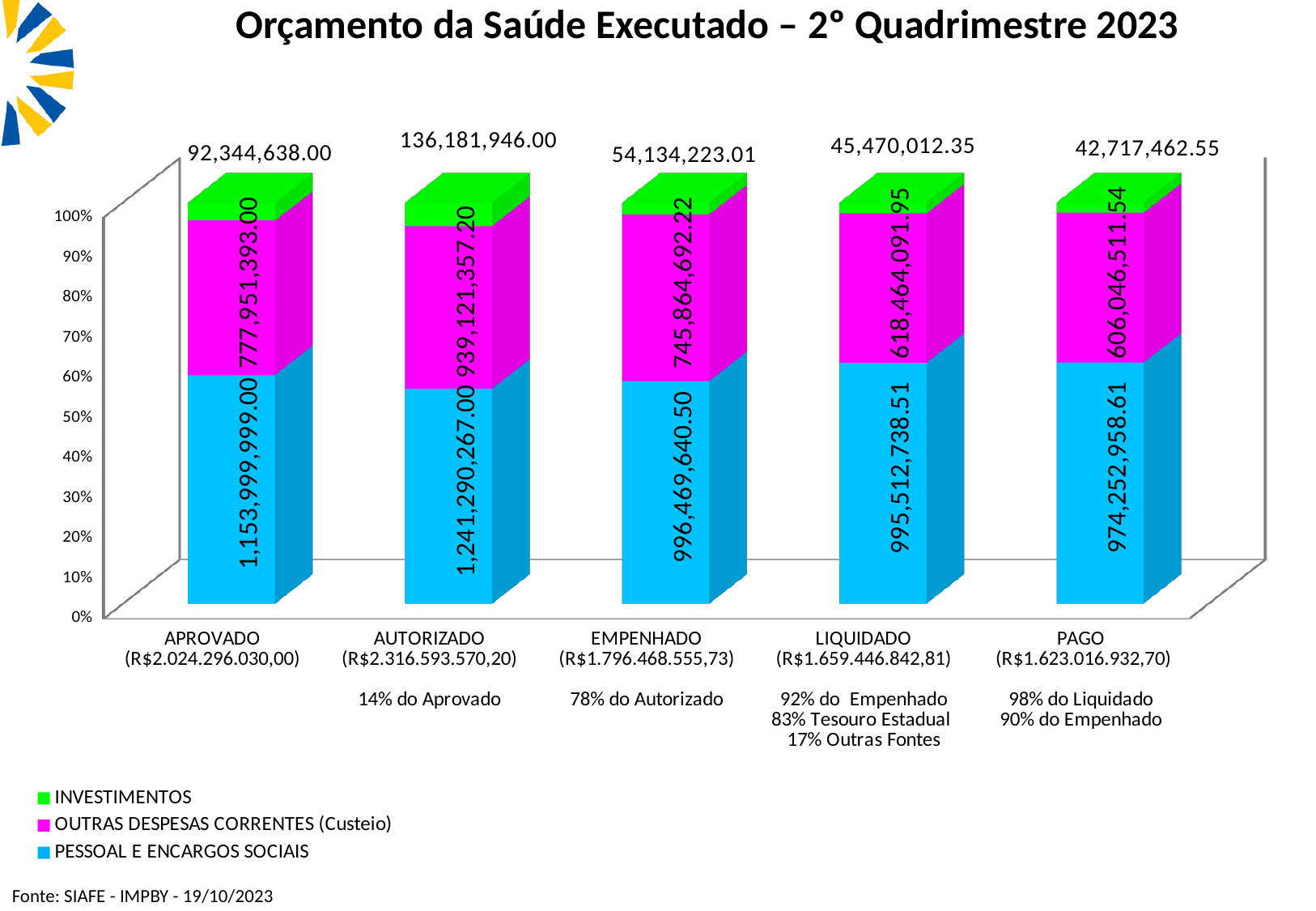
What is the difference between the INVESTIMENTOS values for AUTORIZADO and APROVADO? 43,837,308.00 What is the difference between the PESSOAL E ENCARGOS SOCIAIS values for AUTORIZADO and APROVADO? 87,290,268.00 What is the value of OUTRAS DESPESAS CORRENTES (Custeio) for EMPENHADO? 745,864,692.22 Which category has the highest INVESTIMENTOS value? AUTORIZADO Which is larger, the OUTRAS DESPESAS CORRENTES (Custeio) value for APROVADO or for PAGO? APROVADO What kind of chart is shown on the slide? Stacked bar chart Which category has the lowest INVESTIMENTOS value? PAGO What is the value of PESSOAL E ENCARGOS SOCIAIS for PAGO? 974,252,958.61 What is the value of INVESTIMENTOS for AUTORIZADO? 136,181,946.00 How many categories are shown on the x axis? 5 What total is shown for the LIQUIDADO category? R$1.659.446.842,81 How many series does the legend list? 3